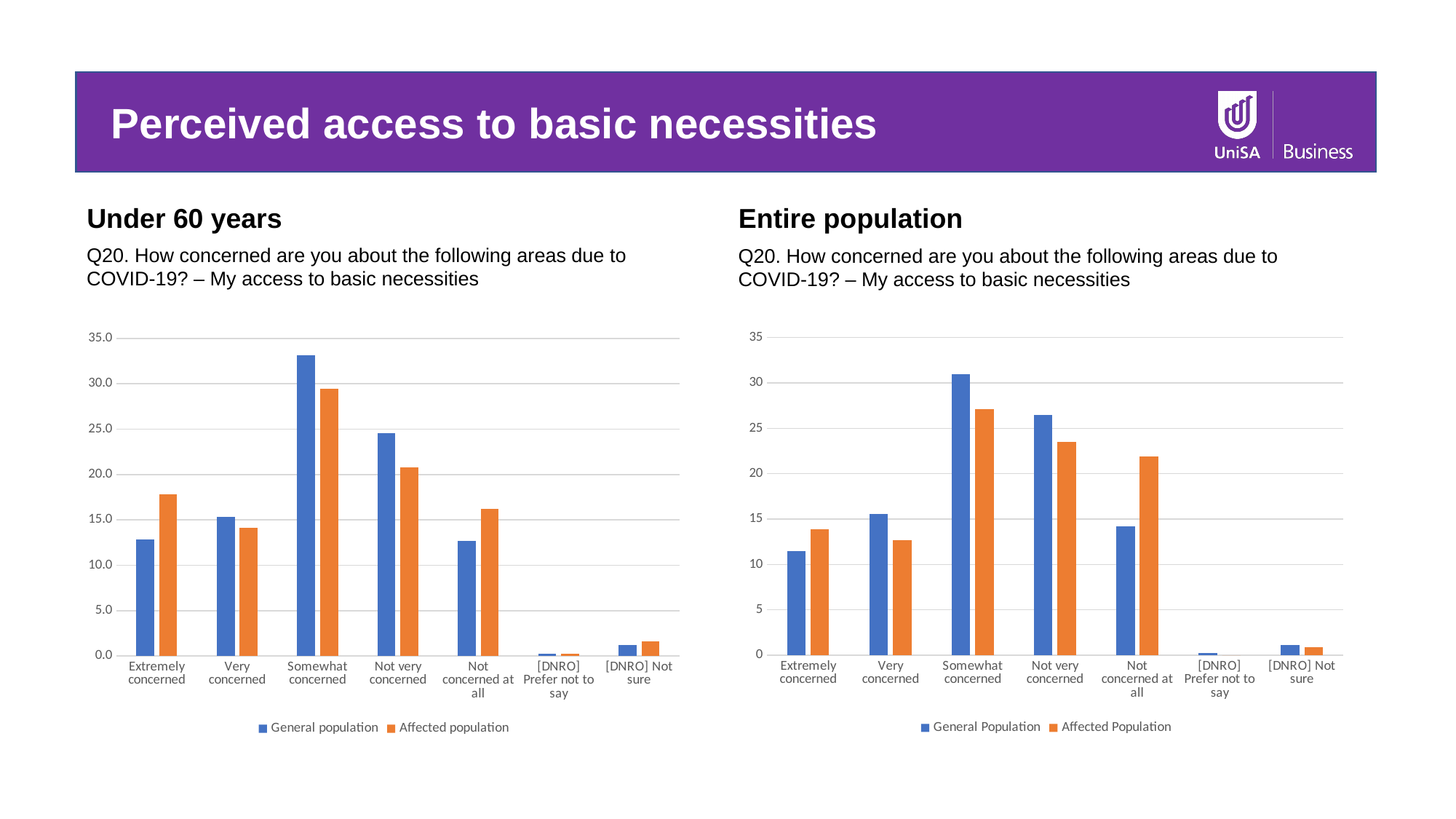
On the Under 60 years chart, which category has the highest value for General population? Somewhat concerned On the Entire population chart, for Not very concerned, which series has the larger value, General Population or Affected Population? General Population On the Entire population chart, is the Affected Population value for Somewhat concerned greater or less than 25? greater On the Under 60 years chart, for Extremely concerned, which series has the larger value, General population or Affected population? Affected population On the Under 60 years chart, what kind of chart is shown? Bar chart On the Under 60 years chart, how many series does the legend list? 2 On the Under 60 years chart, how many categories are shown on the x axis? 7 On the Entire population chart, what are the two legend entries? General Population and Affected Population On the Entire population chart, is the Affected Population value for Not concerned at all greater or less than 20? greater On the Entire population chart, which category has the lowest value for General Population? [DNRO] Prefer not to say On the Under 60 years chart, is the Affected population value for Not very concerned greater or less than 25.0? less